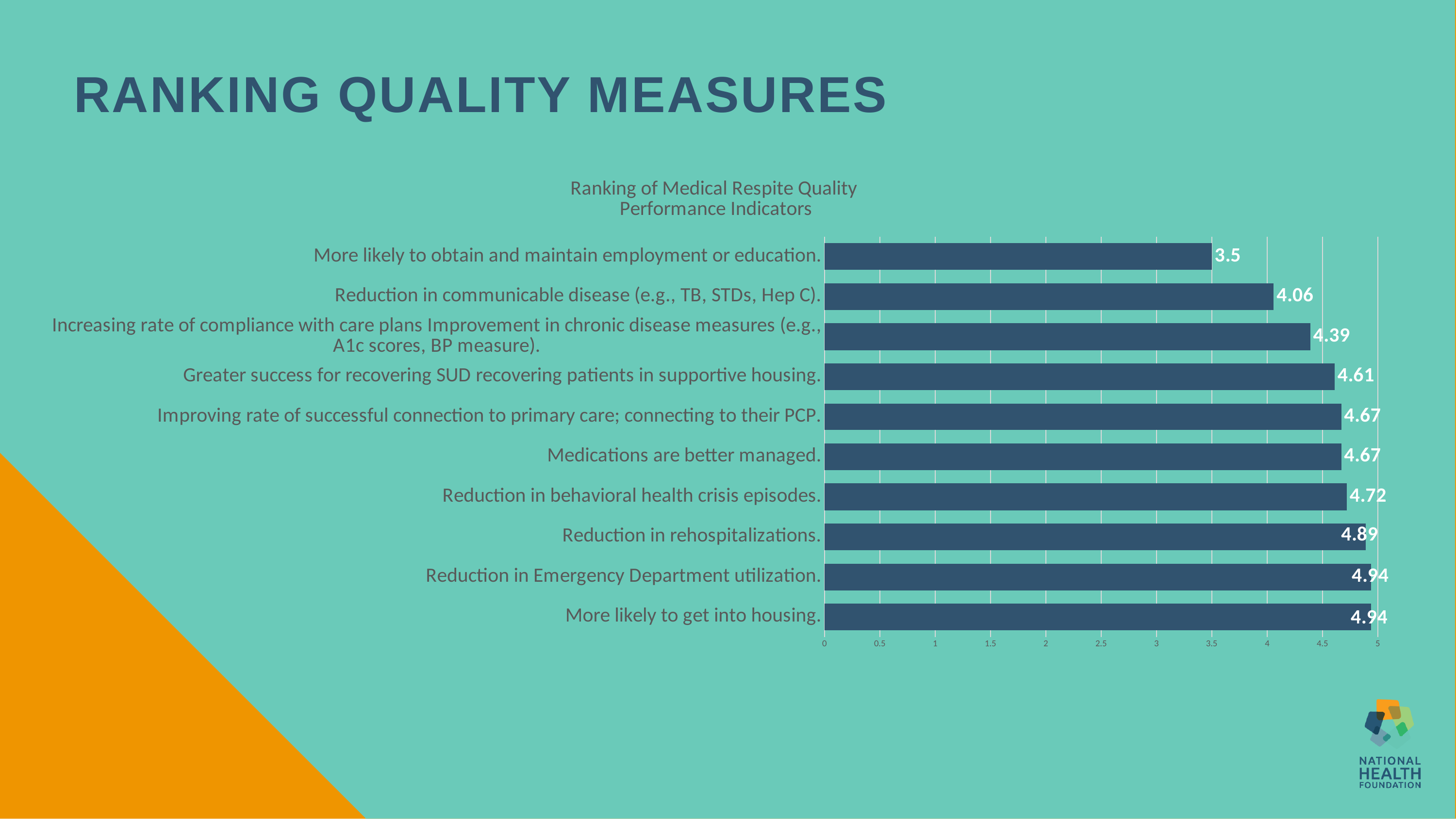
Which has a larger value: "Reduction in communicable disease (e.g., TB, STDs, Hep C)." or "Reduction in Emergency Department utilization."? Reduction in Emergency Department utilization. Is the value for "Medications are better managed." greater or less than 4.5? greater What is the value for "Reduction in behavioral health crisis episodes."? 4.72 What is the difference between the values for "More likely to get into housing." and "Reduction in rehospitalizations."? 0.05 What is the difference between the values for "Reduction in communicable disease (e.g., TB, STDs, Hep C)." and "More likely to obtain and maintain employment or education."? 0.56 How many categories are shown in the chart? 10 What is the title of the chart? Ranking of Medical Respite Quality Performance Indicators What is the value for "Greater success for recovering SUD recovering patients in supportive housing."? 4.61 Which category has the lowest value? More likely to obtain and maintain employment or education. What kind of chart is shown on the slide? Bar chart What is the value for "Reduction in rehospitalizations."? 4.89 What is the value for "More likely to obtain and maintain employment or education."? 3.5